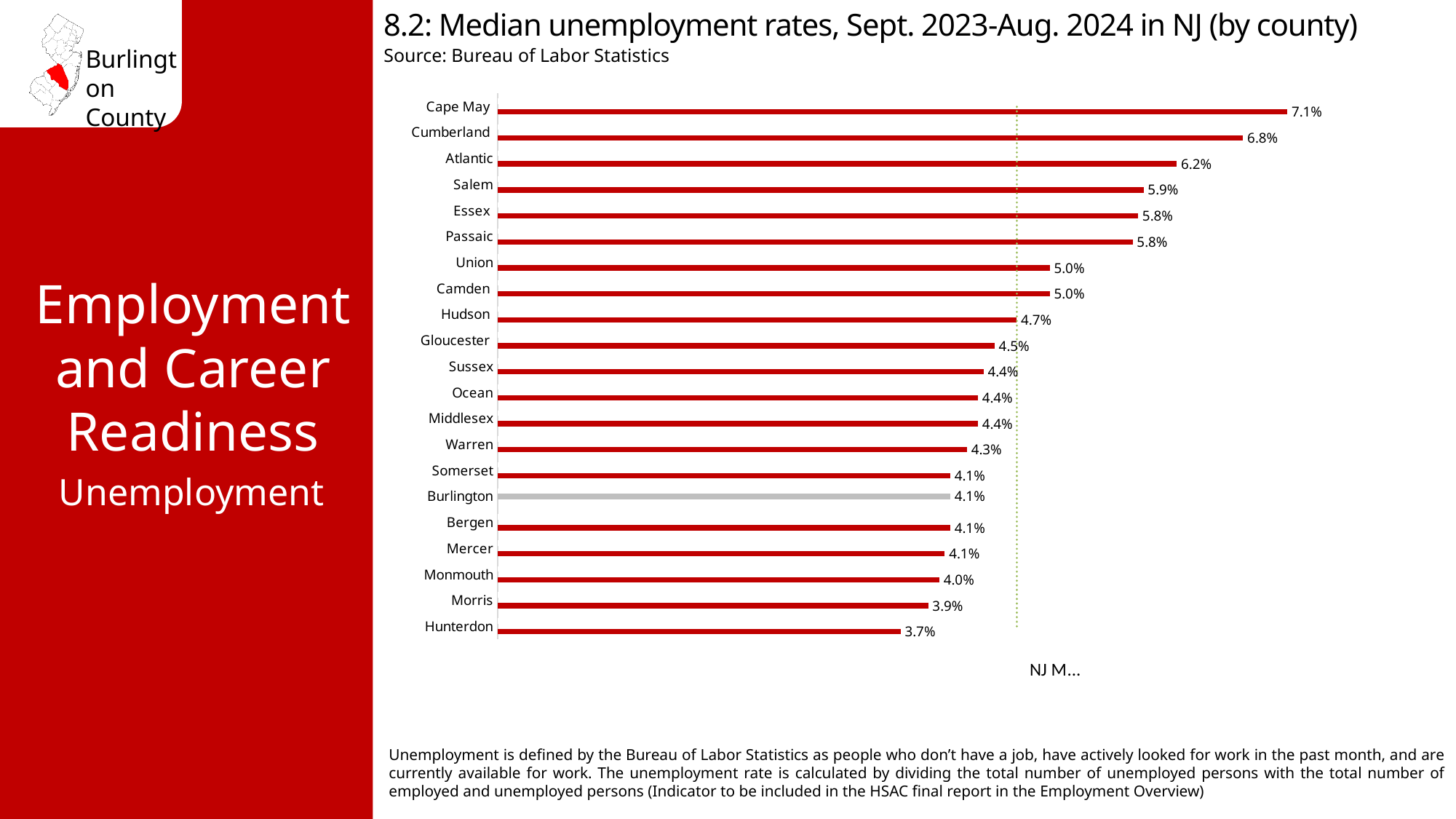
What type of chart is shown on the slide? Bar chart What is the difference between the median unemployment rates of Cape May and Hunterdon? 3.4% What is the median unemployment rate for Burlington? 4.1% How many counties are shown in the chart? 21 What is the median unemployment rate for Cape May? 7.1% What is the difference between the median unemployment rates of Cumberland and Atlantic? 0.6% Which has a higher median unemployment rate, Salem or Gloucester? Salem Which has a higher median unemployment rate, Morris or Warren? Warren Which county's bar is shown in grey rather than red? Burlington What is the median unemployment rate for Hudson? 4.7% Which county has the lowest median unemployment rate? Hunterdon Which county has the highest median unemployment rate? Cape May